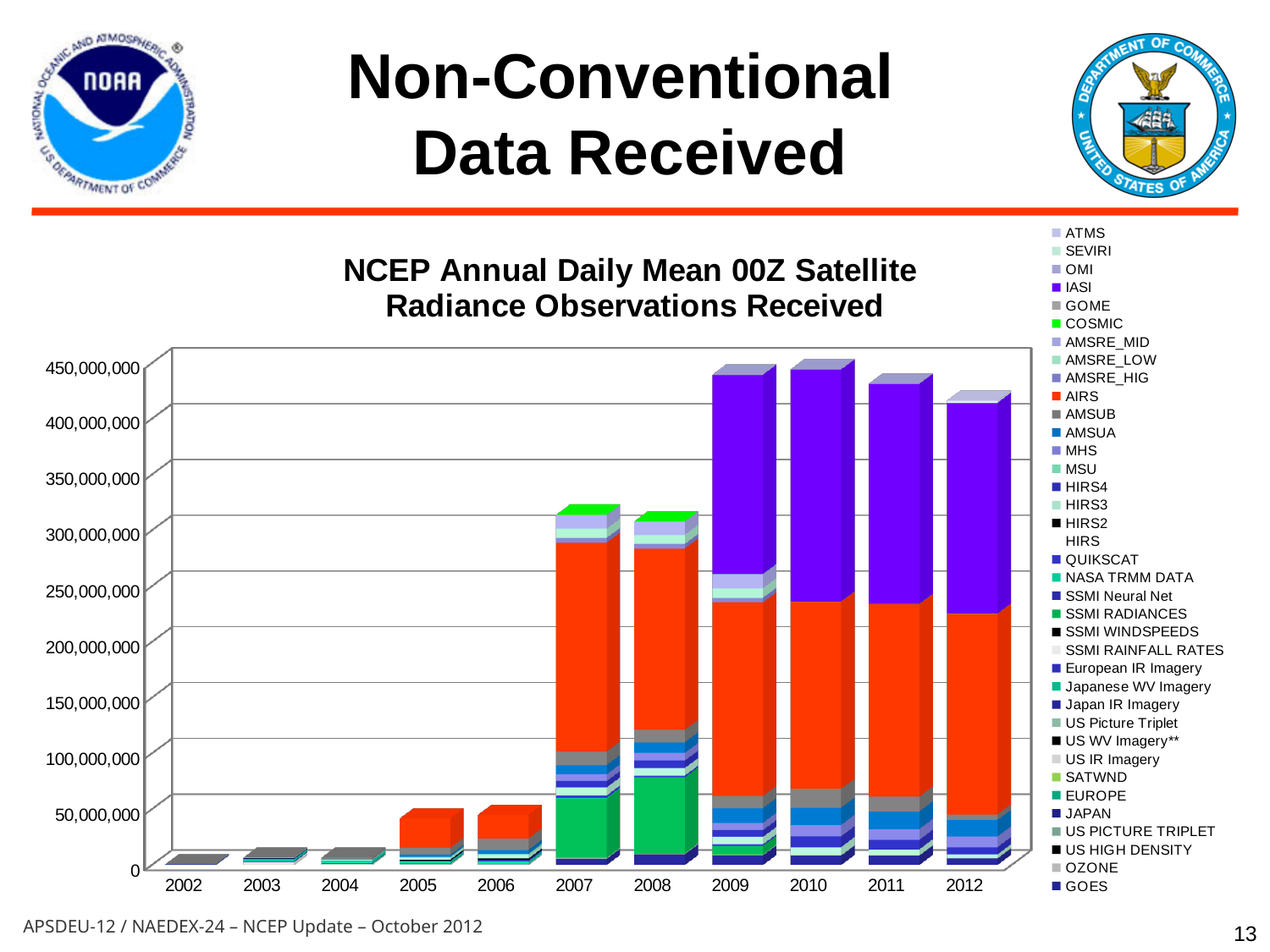
What kind of chart is shown on the slide? stacked bar chart What is the title of the chart? NCEP Annual Daily Mean 00Z Satellite Radiance Observations Received How many years are shown along the x axis of the chart? 11 Which series is listed first in the chart's legend? ATMS Do the total observations received generally rise or fall from 2002 to 2009? rise Is the total value for 2010 greater or less than 400,000,000? greater Which year has the lowest total of satellite radiance observations received? 2002 Is the total value for 2005 greater or less than 100,000,000? less Is the total value for 2007 greater or less than 250,000,000? greater Which year has the larger total, 2008 or 2009? 2009 How many series does the chart's legend list? 37